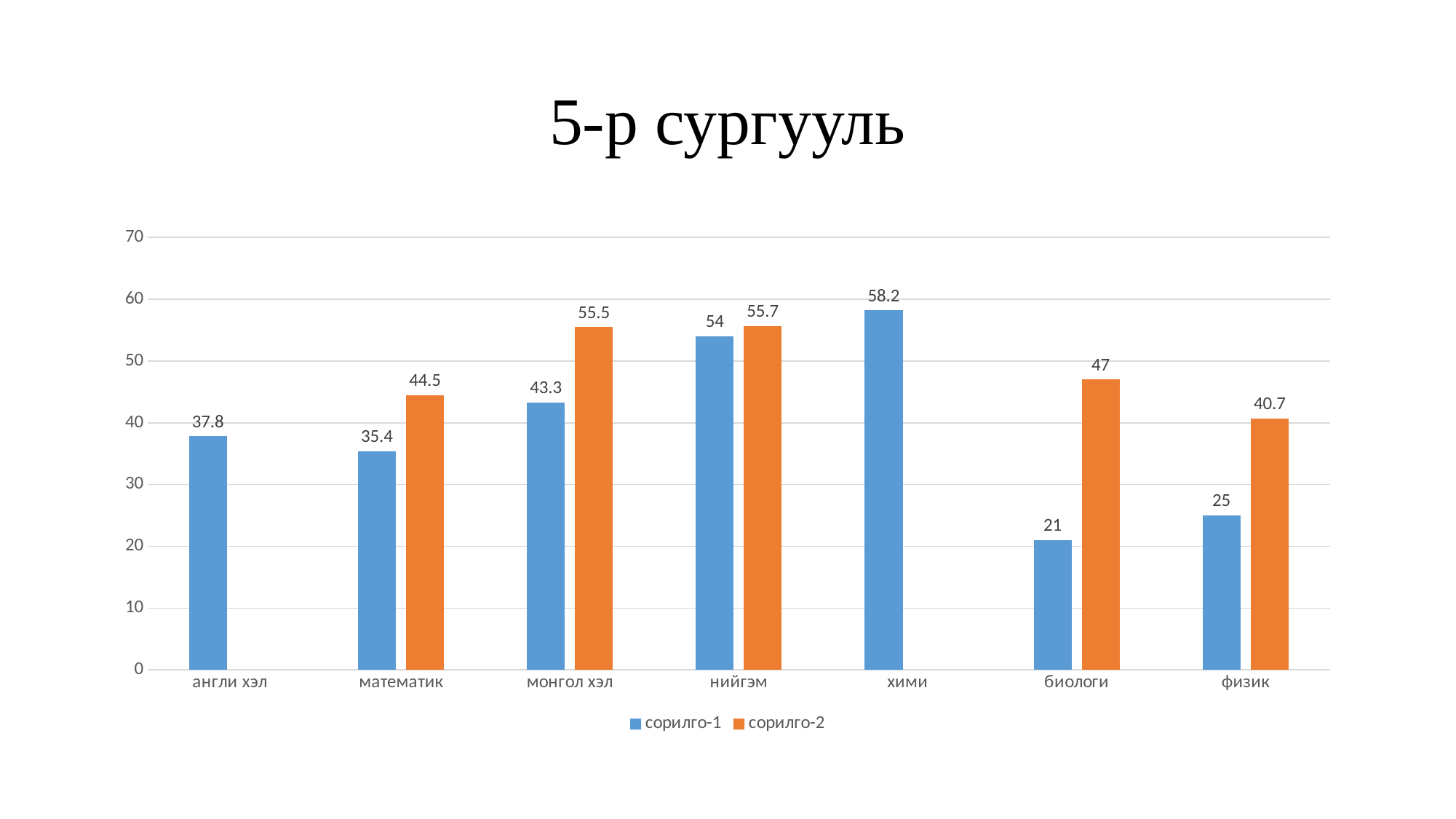
Which category has the highest сорилго-2 value? нийгэм What is the title of the slide? 5-р сургууль What is the value for сорилго-1 in математик? 35.4 What is the value for сорилго-1 in хими? 58.2 How many categories are shown on the x axis? 7 How many series does the legend list? 2 Which is larger in монгол хэл: сорилго-1 or сорилго-2? сорилго-2 Which category has the lowest сорилго-1 value? биологи What is the difference between сорилго-2 and сорилго-1 in биологи? 26 Which category has the highest сорилго-1 value? хими What is the value for сорилго-2 in биологи? 47 What kind of chart is shown on the slide? bar chart